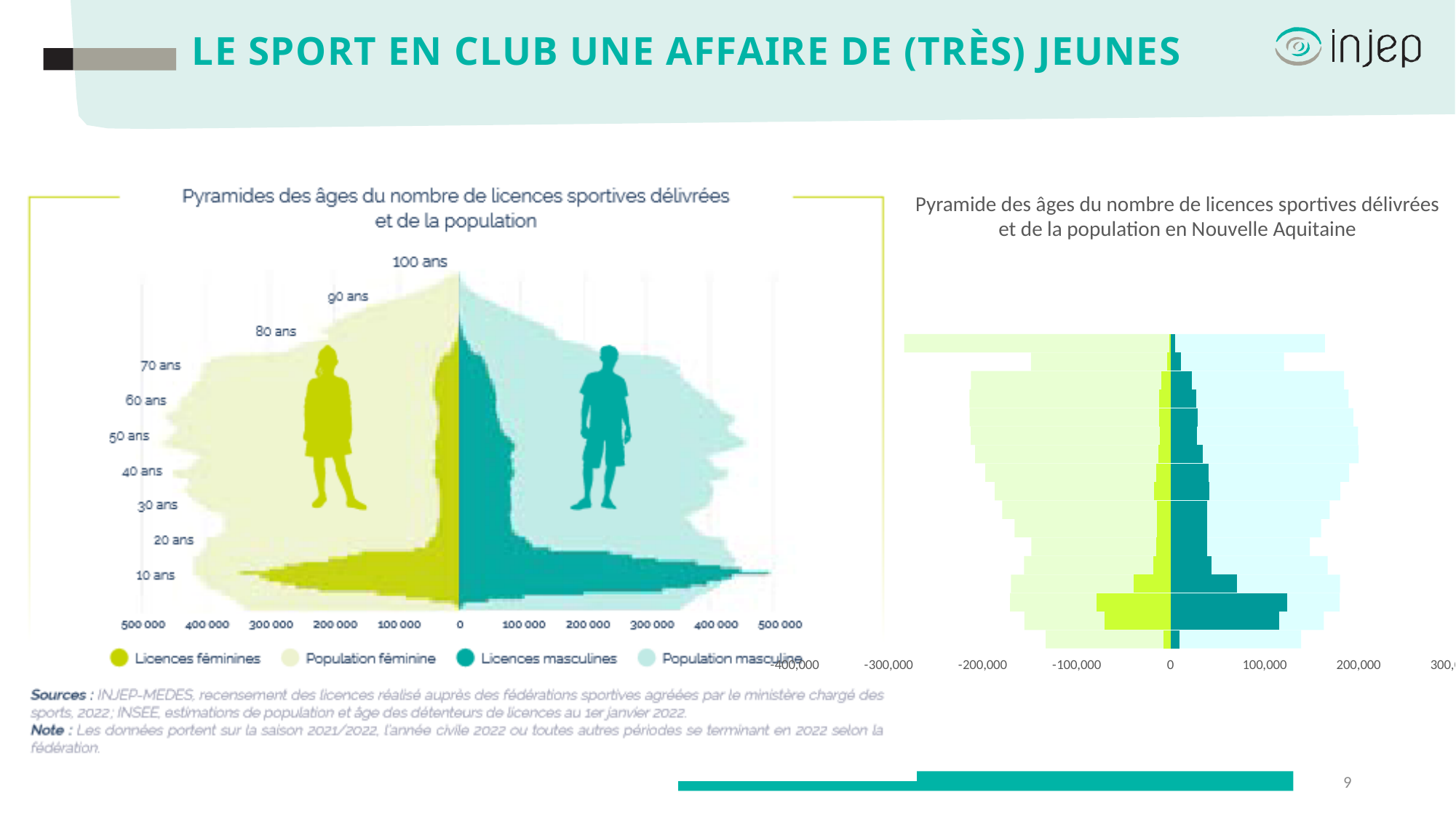
What kind of chart is the right chart titled 'Pyramide des âges du nombre de licences sportives délivrées et de la population en Nouvelle Aquitaine'? Bar chart (population pyramid) How many series does the legend of the left chart list? 4 In the left chart, which series is shown in dark teal? Licences masculines In the left chart, at 10 ans, which is larger: Licences masculines or Licences féminines? Licences masculines In the left chart, what is the highest age label shown on the vertical axis? 100 ans In the right chart, what is the leftmost value shown on the horizontal axis? -400,000 In the left chart, is the value of Licences masculines at 10 ans greater or less than 300 000? greater In the right chart, is the longest dark teal bar (bottom of the pyramid) greater or less than 100,000? greater In the left chart, do the Licences masculines values rise or fall as age increases from 10 ans to 90 ans? fall What kind of chart is the left chart titled 'Pyramides des âges du nombre de licences sportives délivrées et de la population'? Bar chart (population pyramid) In the left chart, is the value of Licences féminines at 70 ans greater or less than 100 000? less